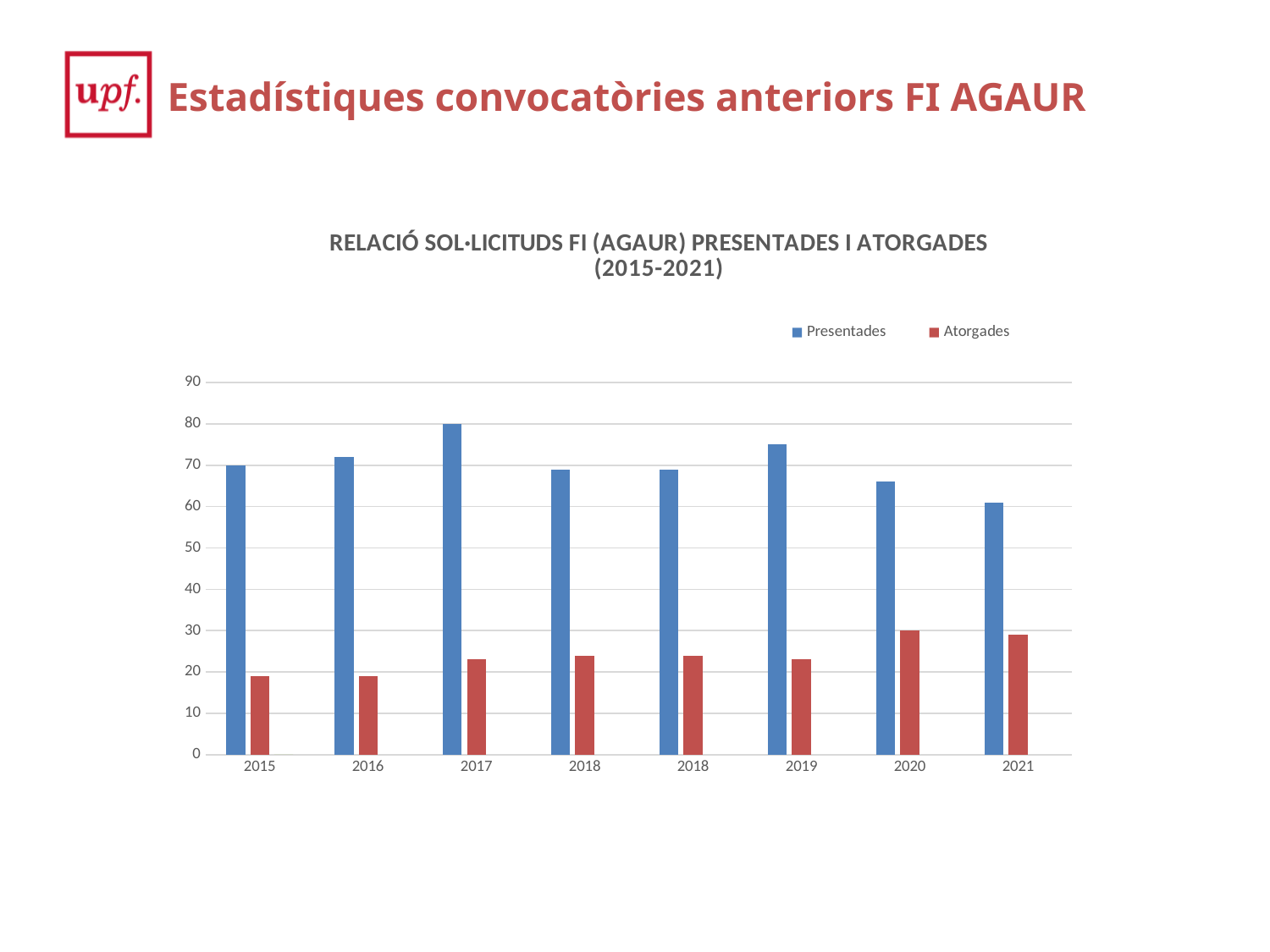
How many series does the legend list? 2 What is the value for Presentades in 2017? 80 What are the two series named in the legend? Presentades and Atorgades Is the value for Atorgades in 2020 greater or less than 20? greater Is the value for Presentades in 2021 greater or less than 70? less Which year has the lowest value for Presentades? 2021 Which is larger, Presentades in 2019 or Presentades in 2020? Presentades in 2019 Which year has the highest value for Presentades? 2017 What kind of chart is shown on the slide? bar chart How many year categories are shown on the x axis? 8 Do the Presentades values rise or fall from 2019 to 2021? fall Is the value for Atorgades in 2017 greater or less than 30? less